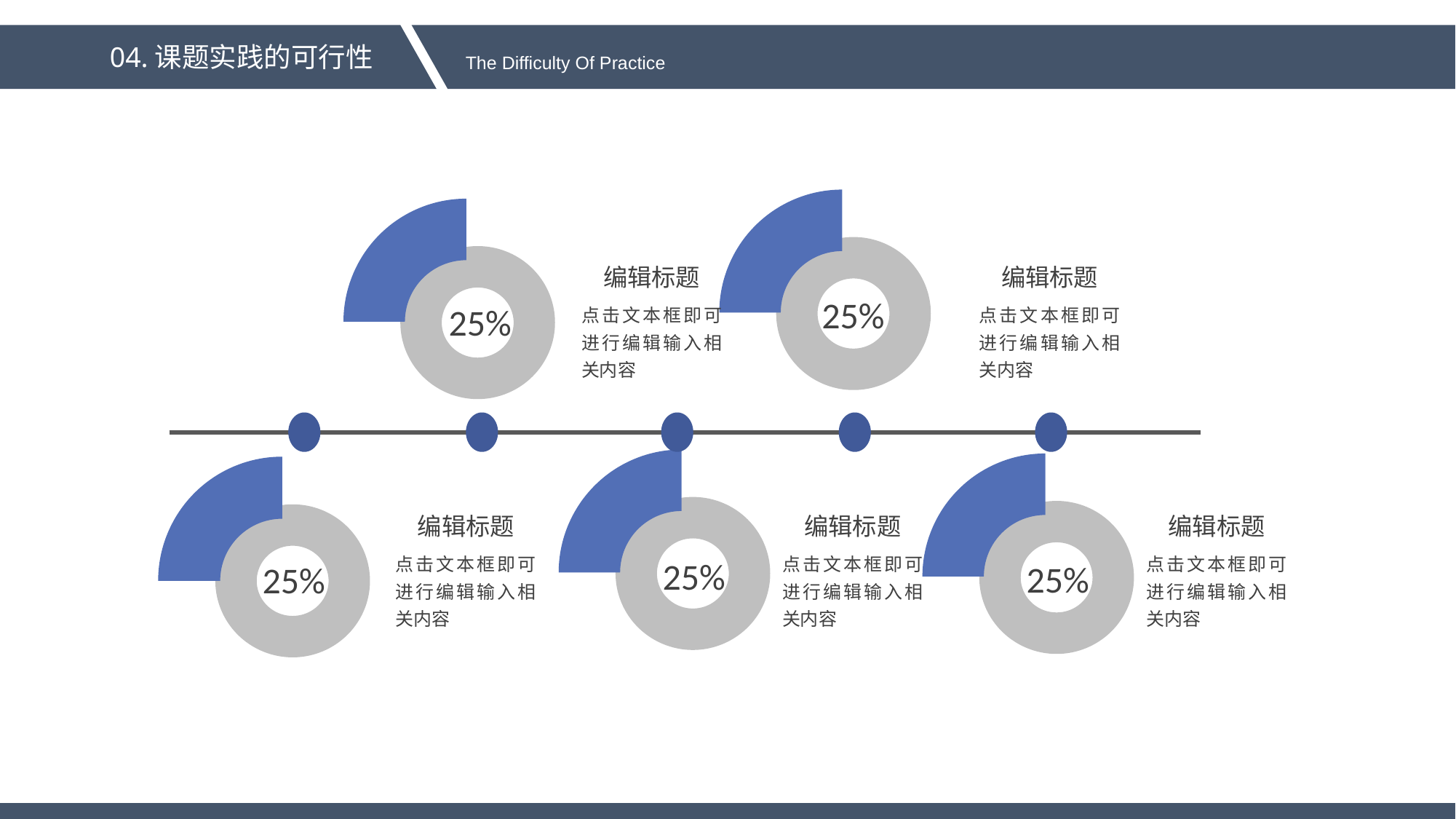
What percentage is printed in the centre of the top-left donut chart? 25% What colour is the highlighted segment in each donut chart? Blue What percentage is printed in the centre of the bottom-right donut chart? 25% What kind of chart is used for each of the five graphics on the slide? Donut (pie) chart How many circular markers are placed along the horizontal timeline between the charts? 5 What colour is the remaining (non-highlighted) portion of each donut chart? Grey What percentage is printed in the centre of the top-right donut chart? 25% Do all five donut charts on the slide show the same percentage value? Yes What percentage is printed in the centre of the bottom-left donut chart? 25% What percentage is printed in the centre of the bottom-middle donut chart? 25% In the top-left donut chart, what share of the ring does the blue segment represent? 25% How many donut charts are shown on the slide? 5